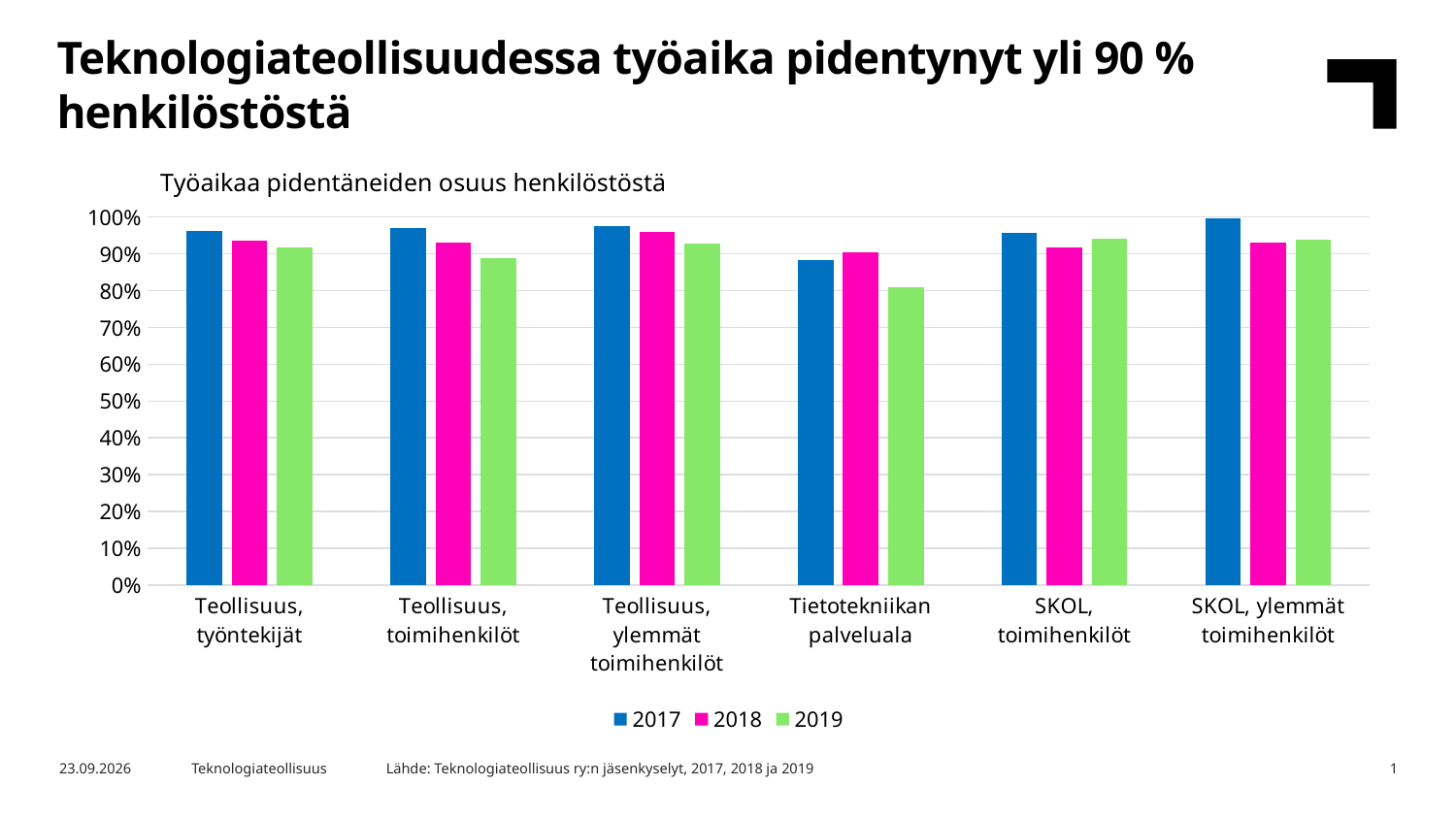
What is the title of the chart? Työaikaa pidentäneiden osuus henkilöstöstä Which category has the lowest 2017 value? Tietotekniikan palveluala Is the 2017 value for SKOL, ylemmät toimihenkilöt greater or less than 90%? greater Is the 2017 value for Teollisuus, työntekijät greater or less than 90%? greater Which years are listed in the chart legend? 2017, 2018, 2019 For Teollisuus, toimihenkilöt, which is larger: the 2017 value or the 2019 value? 2017 Is the 2019 value for Tietotekniikan palveluala greater or less than 90%? less What kind of chart is shown on the slide? bar chart How many series does the chart legend list? 3 How many categories are shown on the x axis of the chart? 6 Which category has the lowest 2019 value? Tietotekniikan palveluala For Teollisuus, toimihenkilöt, do the values rise or fall from 2017 to 2019? fall